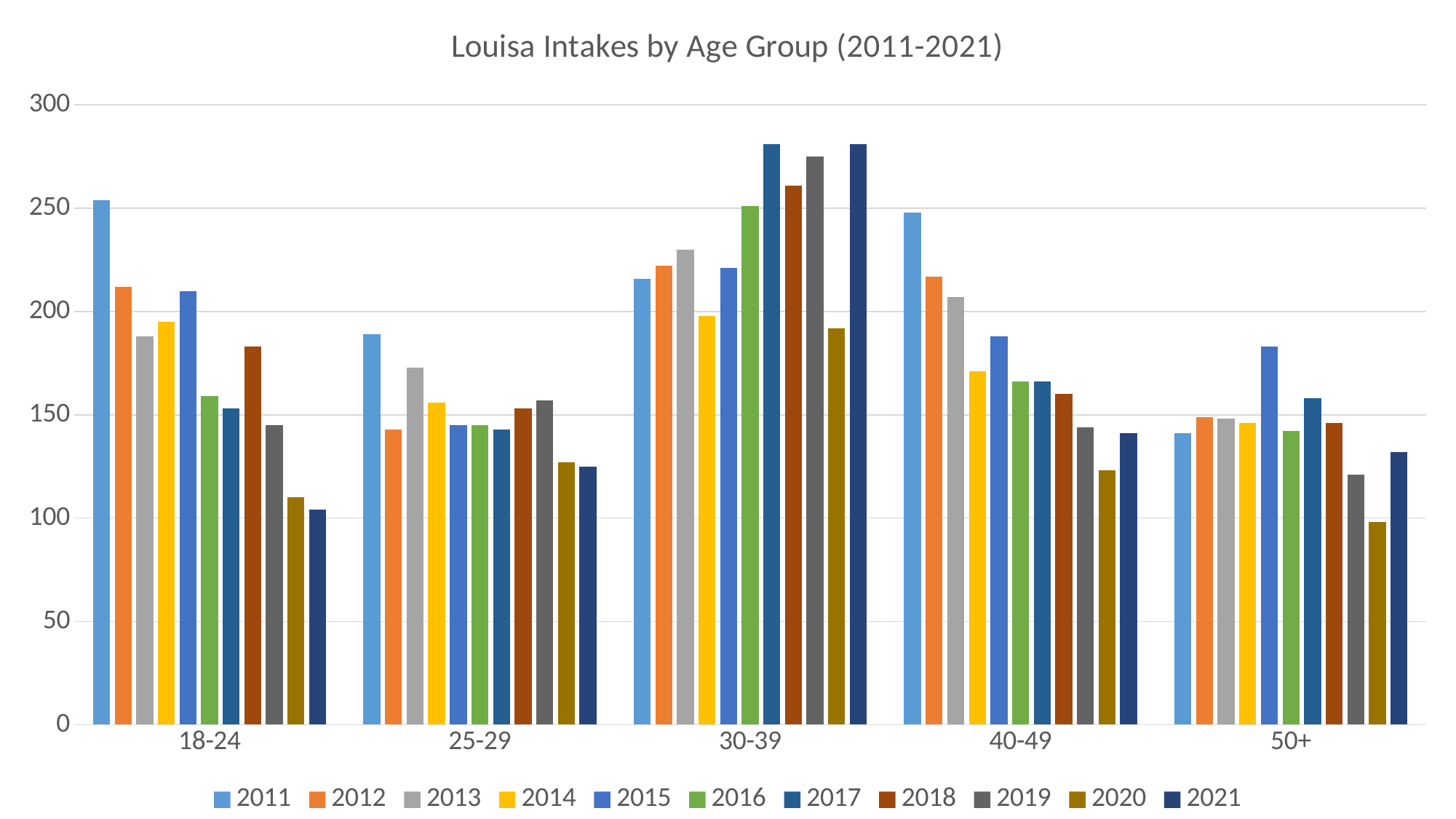
What is the title of the chart? Louisa Intakes by Age Group (2011-2021) How many series does the legend list? 11 Which year has the lowest value in the 40-49 age group? 2020 Which is larger in the 50+ age group: the value for 2015 or the value for 2016? 2015 Which year has the highest value in the 40-49 age group? 2011 How many age group categories are shown on the x axis? 5 Which year has the highest value in the 18-24 age group? 2011 What kind of chart is shown on the slide? bar chart Which is larger: the 2011 value for 18-24 or the 2011 value for 25-29? 18-24 Which year has the lowest value in the 50+ age group? 2020 Is the value for 2017 in the 30-39 age group greater or less than 250? greater Is the value for 2021 in the 18-24 age group greater or less than 150? less